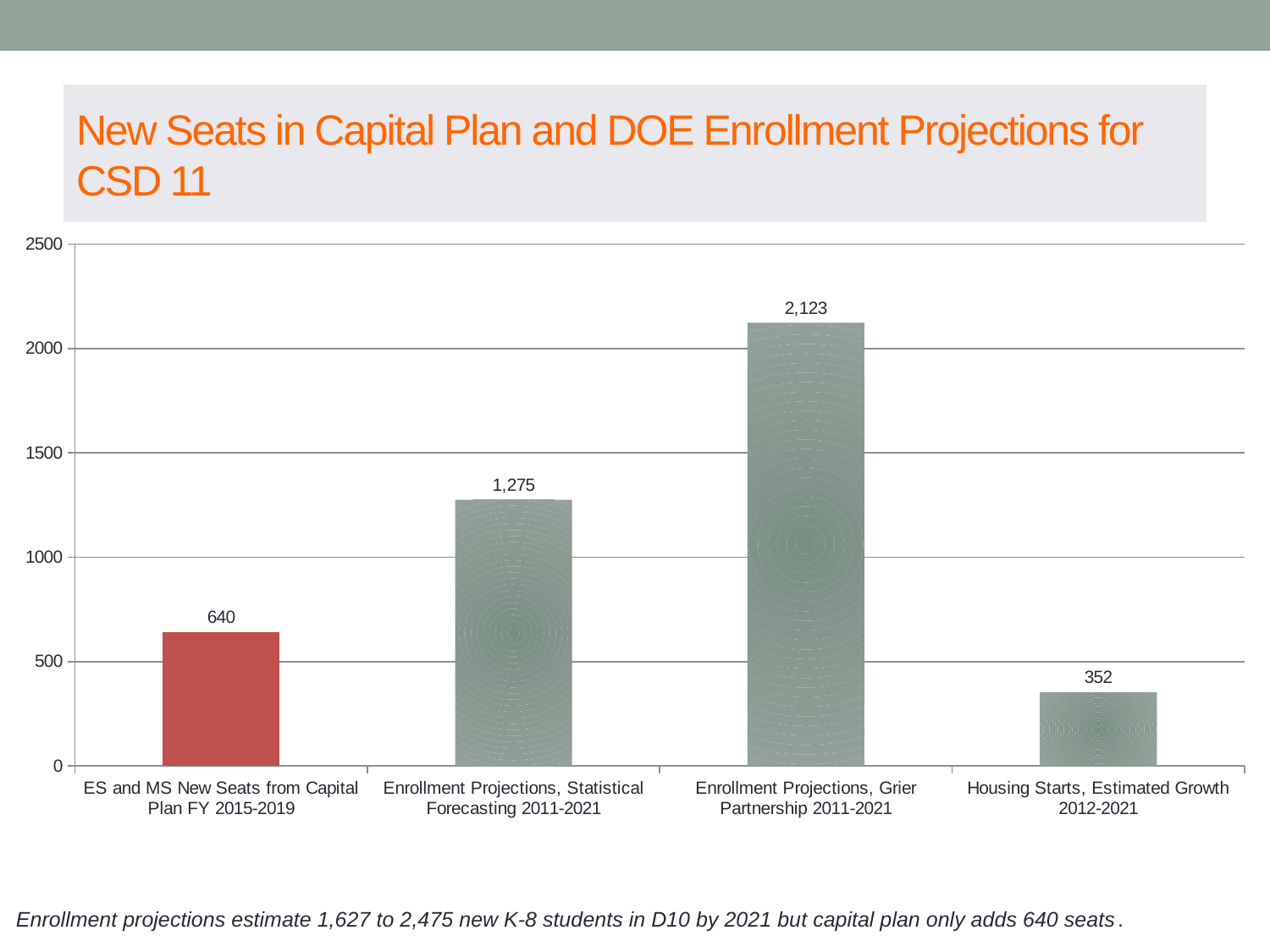
What type of chart is shown on the slide? Bar chart What is the value for Housing Starts, Estimated Growth 2012-2021? 352 Is the value for Enrollment Projections, Grier Partnership 2011-2021 greater or less than 2000? greater How many categories are shown in the chart? 4 What is the difference between the Statistical Forecasting enrollment projection and the ES and MS New Seats from Capital Plan FY 2015-2019? 635 What is the difference between the Grier Partnership enrollment projection and the Statistical Forecasting enrollment projection? 848 What is the value for Enrollment Projections, Statistical Forecasting 2011-2021? 1,275 Which category has the highest value? Enrollment Projections, Grier Partnership 2011-2021 Which category has the lowest value? Housing Starts, Estimated Growth 2012-2021 Which is larger: ES and MS New Seats from Capital Plan FY 2015-2019 or Housing Starts, Estimated Growth 2012-2021? ES and MS New Seats from Capital Plan FY 2015-2019 What is the value for ES and MS New Seats from Capital Plan FY 2015-2019? 640 What is the value for Enrollment Projections, Grier Partnership 2011-2021? 2,123